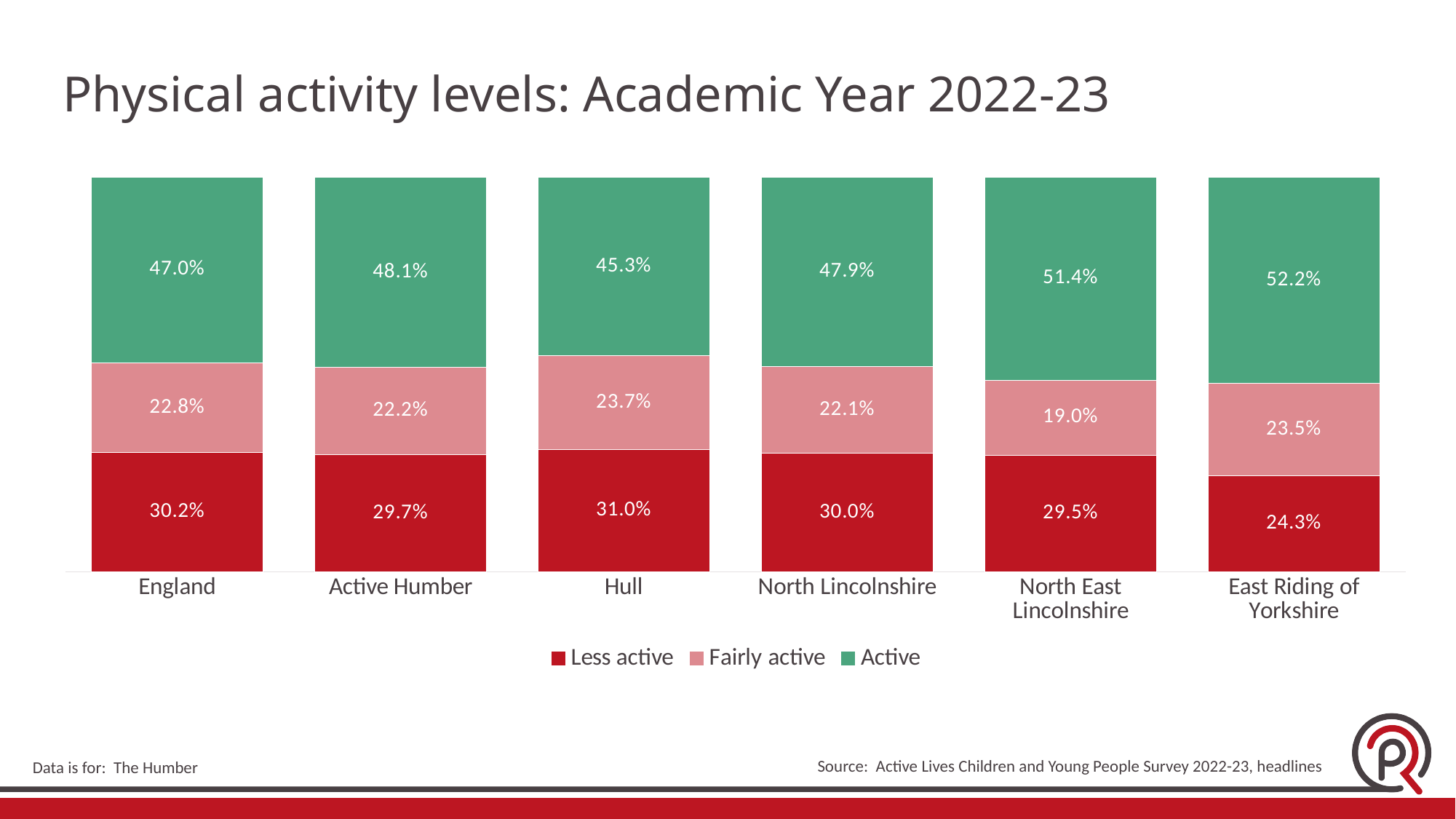
What is the Active value for Hull? 45.3% What is the difference between the Active values for East Riding of Yorkshire and Hull? 6.9 percentage points What is the Less active value for East Riding of Yorkshire? 24.3% Which is larger, the Less active value for England or for North Lincolnshire? England Which area has the highest Active value? East Riding of Yorkshire How many areas are shown on the x axis? 6 Which area has the lowest Fairly active value? North East Lincolnshire What is the Fairly active value for North East Lincolnshire? 19.0% Which area has the highest Less active value? Hull What is the Active value for Active Humber? 48.1% What kind of chart is shown on the slide? Stacked bar chart How many series does the legend list? 3